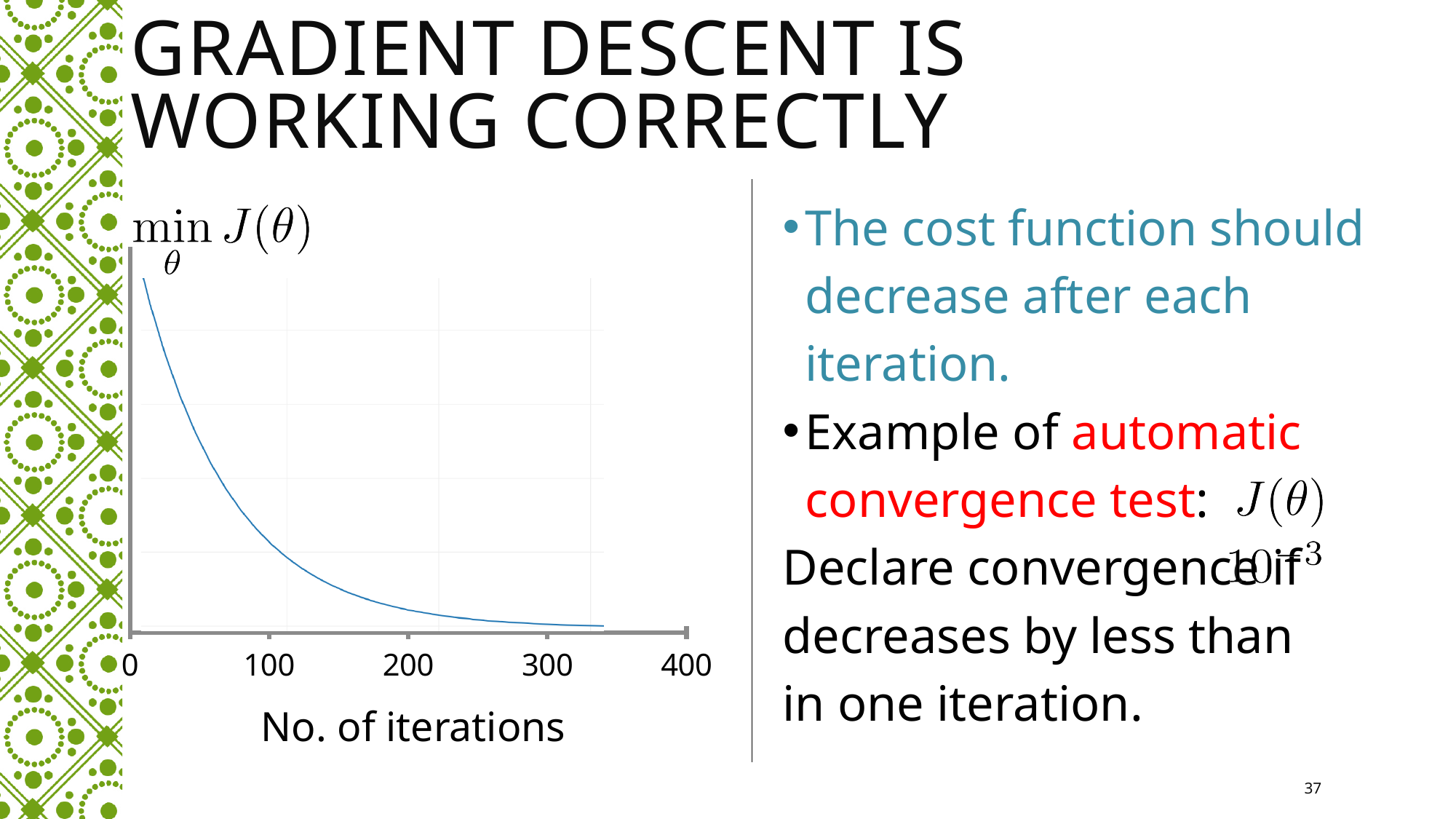
What is the largest tick value shown on the x axis of the chart? 400 What is the label of the x axis of the chart? No. of iterations What kind of chart is shown on the slide? line chart Does the plotted line rise or fall as the number of iterations increases? fall